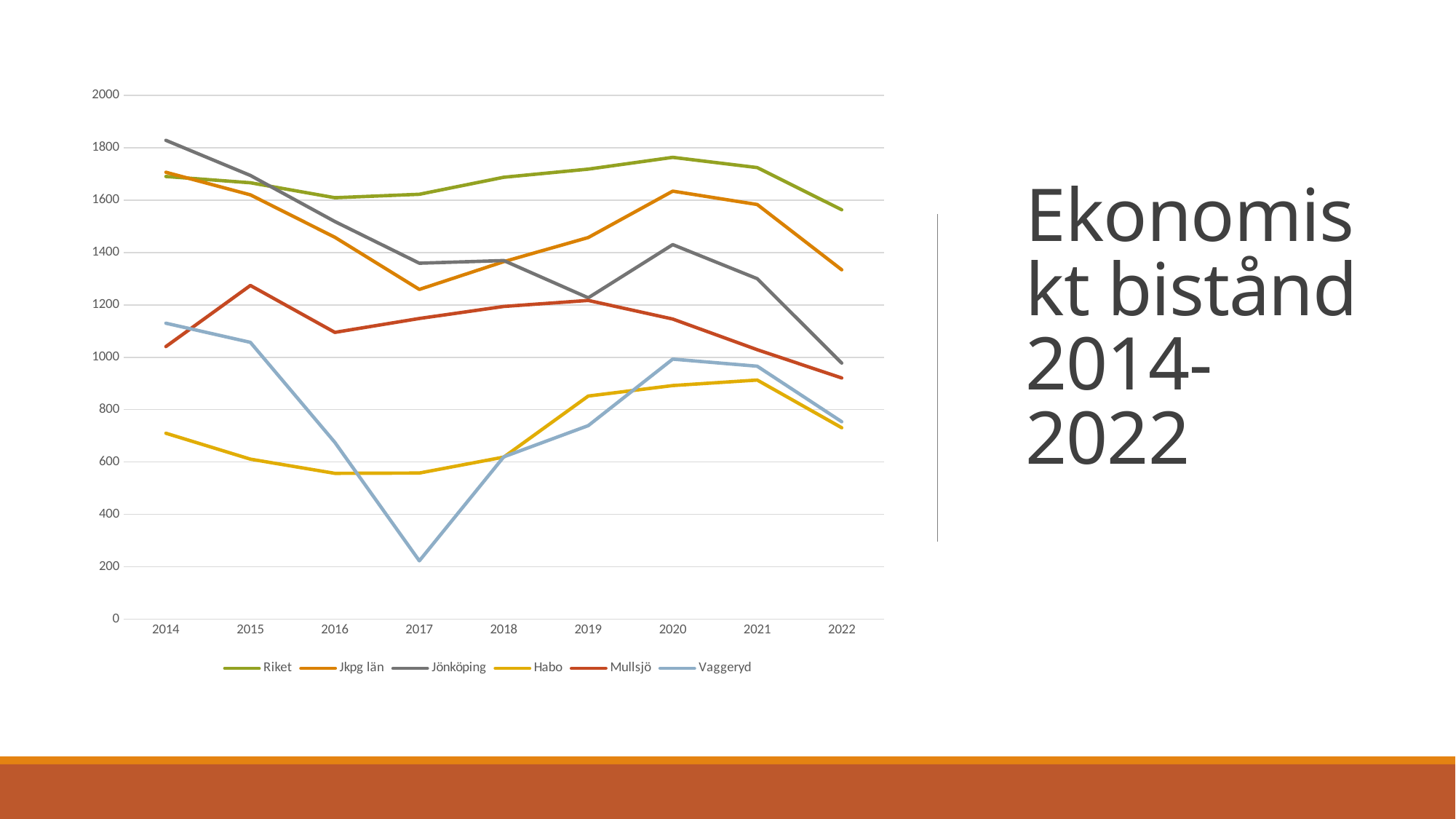
How many years are shown on the x axis? 9 Which series has the highest value in 2022? Riket Does the Jönköping line rise or fall from 2014 to 2017? fall How many series does the legend list? 6 Which series has the lowest value in 2017? Vaggeryd In which year is the Vaggeryd line at its lowest? 2017 What kind of chart is shown on the slide? line chart Is the value for Vaggeryd in 2017 greater or less than 400? less Which is larger in 2014, Jönköping or Mullsjö? Jönköping Is the value for Mullsjö in 2015 greater or less than 1200? greater Is the value for Habo in 2016 greater or less than 600? less